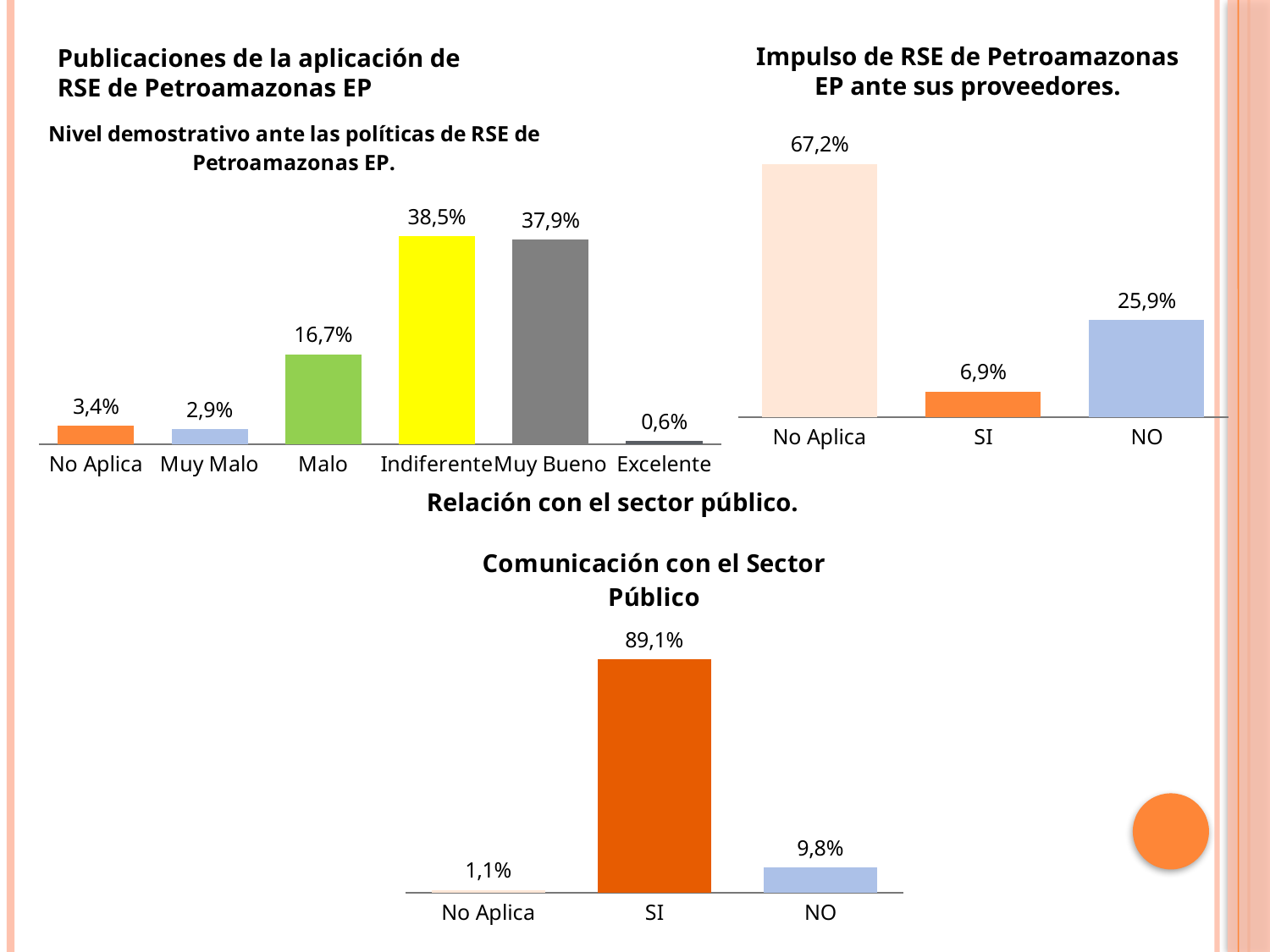
In the chart titled "Impulso de RSE de Petroamazonas EP ante sus proveedores.", what is the difference between No Aplica and SI? 60,3% In the chart titled "Impulso de RSE de Petroamazonas EP ante sus proveedores.", what is the value for NO? 25,9% In the chart titled "Nivel demostrativo ante las políticas de RSE de Petroamazonas EP.", which category has the lowest value? Excelente In the chart titled "Comunicación con el Sector Público", what is the difference between SI and NO? 79,3% In the chart titled "Comunicación con el Sector Público", what is the value for SI? 89,1% What kind of chart is the chart titled "Comunicación con el Sector Público"? Bar chart In the chart titled "Impulso de RSE de Petroamazonas EP ante sus proveedores.", which category has the highest value? No Aplica In the chart titled "Nivel demostrativo ante las políticas de RSE de Petroamazonas EP.", what is the value for Indiferente? 38,5% In the chart titled "Nivel demostrativo ante las políticas de RSE de Petroamazonas EP.", how many categories are shown? 6 In the chart titled "Nivel demostrativo ante las políticas de RSE de Petroamazonas EP.", which is larger, No Aplica or Muy Malo? No Aplica In the chart titled "Comunicación con el Sector Público", which category has the lowest value? No Aplica In the chart titled "Nivel demostrativo ante las políticas de RSE de Petroamazonas EP.", what is the difference between Malo and Muy Malo? 13,8%